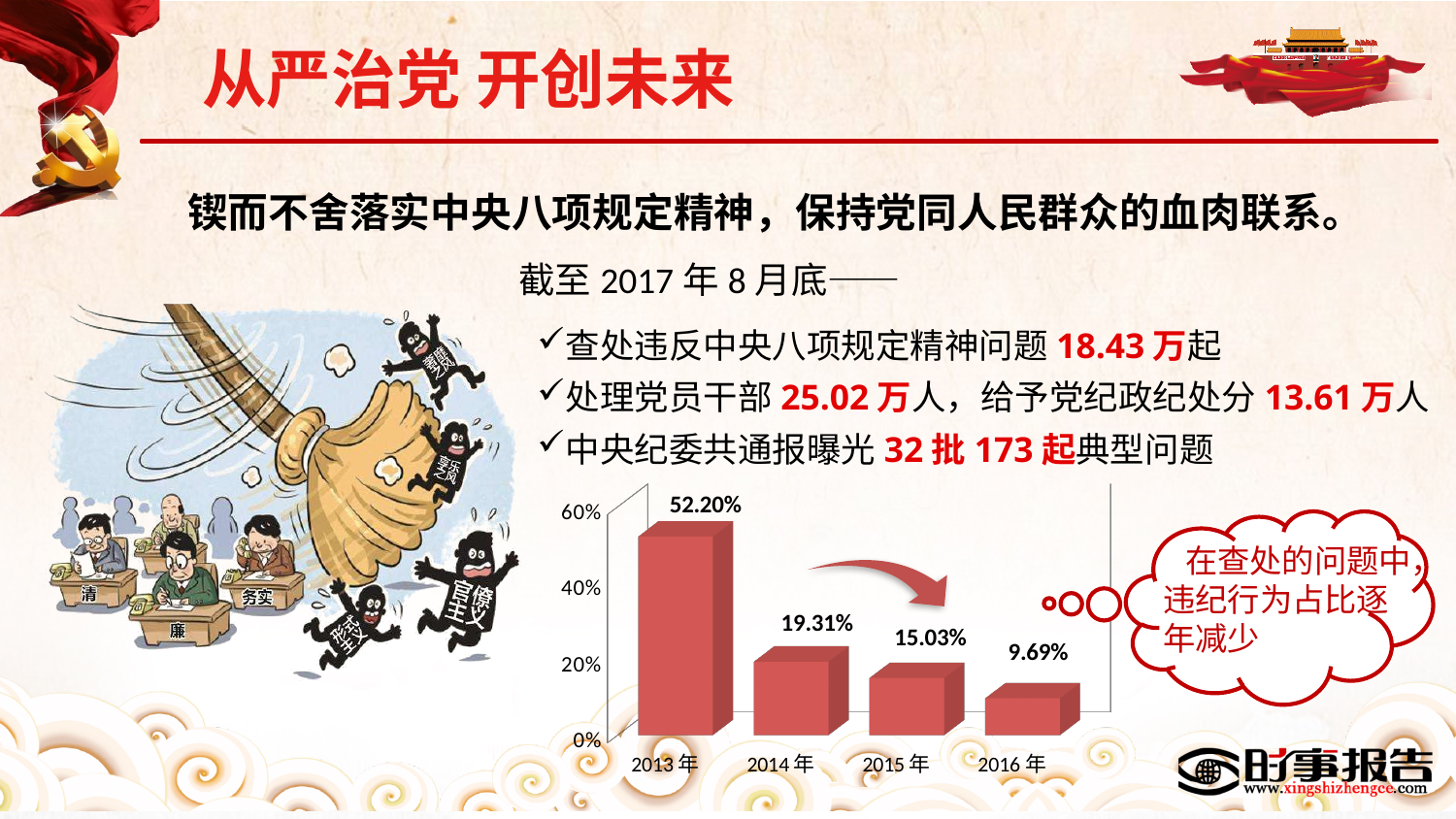
Which year has the highest value? 2013年 Do the values rise or fall from 2013年 to 2016年? fall What is the difference between the values for 2015年 and 2016年? 5.34% What is the value for 2013年? 52.20% How many years are shown on the chart? 4 What is the difference between the values for 2013年 and 2014年? 32.89% What kind of chart is shown on the slide? bar chart What is the value for 2015年? 15.03% What is the value for 2014年? 19.31% Which is larger, the value for 2014年 or the value for 2015年? 2014年 Which year has the lowest value? 2016年 What is the value for 2016年? 9.69%